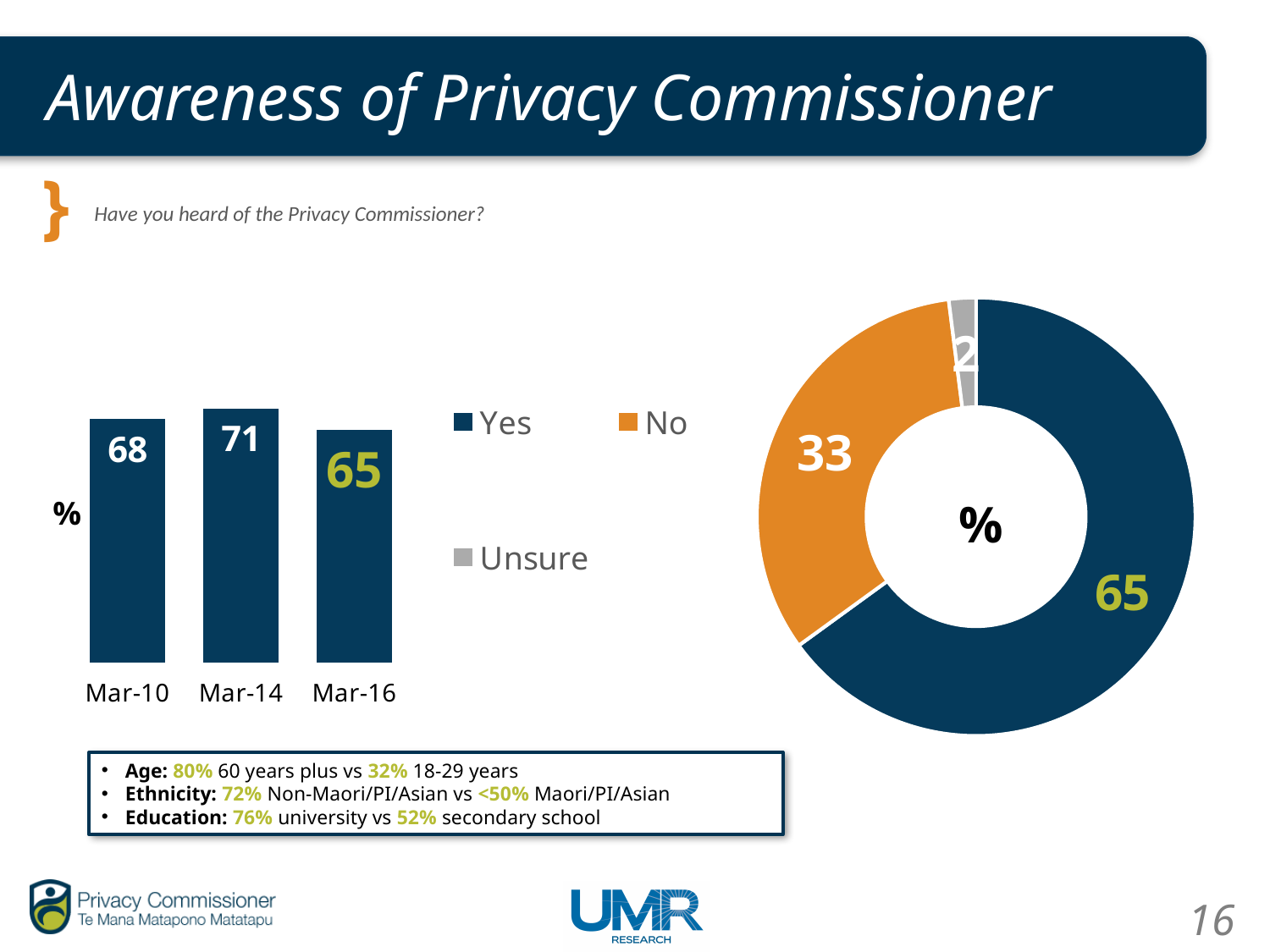
On the donut chart on the right, what is the value for Unsure? 2 On the bar chart on the left, which category has the highest value? Mar-14 On the bar chart on the left, what is the value for Mar-10? 68 On the donut chart on the right, which category has the largest share? Yes How many entries does the legend for the donut chart list? 3 On the bar chart on the left, what is the value for Mar-14? 71 What kind of chart is the chart on the left of the slide? Bar chart On the bar chart on the left, which is larger, the value for Mar-10 or the value for Mar-16? Mar-10 On the donut chart on the right, what is the value for No? 33 How many categories are shown on the bar chart on the left? 3 On the bar chart on the left, what is the difference between the Mar-14 and Mar-16 values? 6 On the bar chart on the left, which category has the lowest value? Mar-16